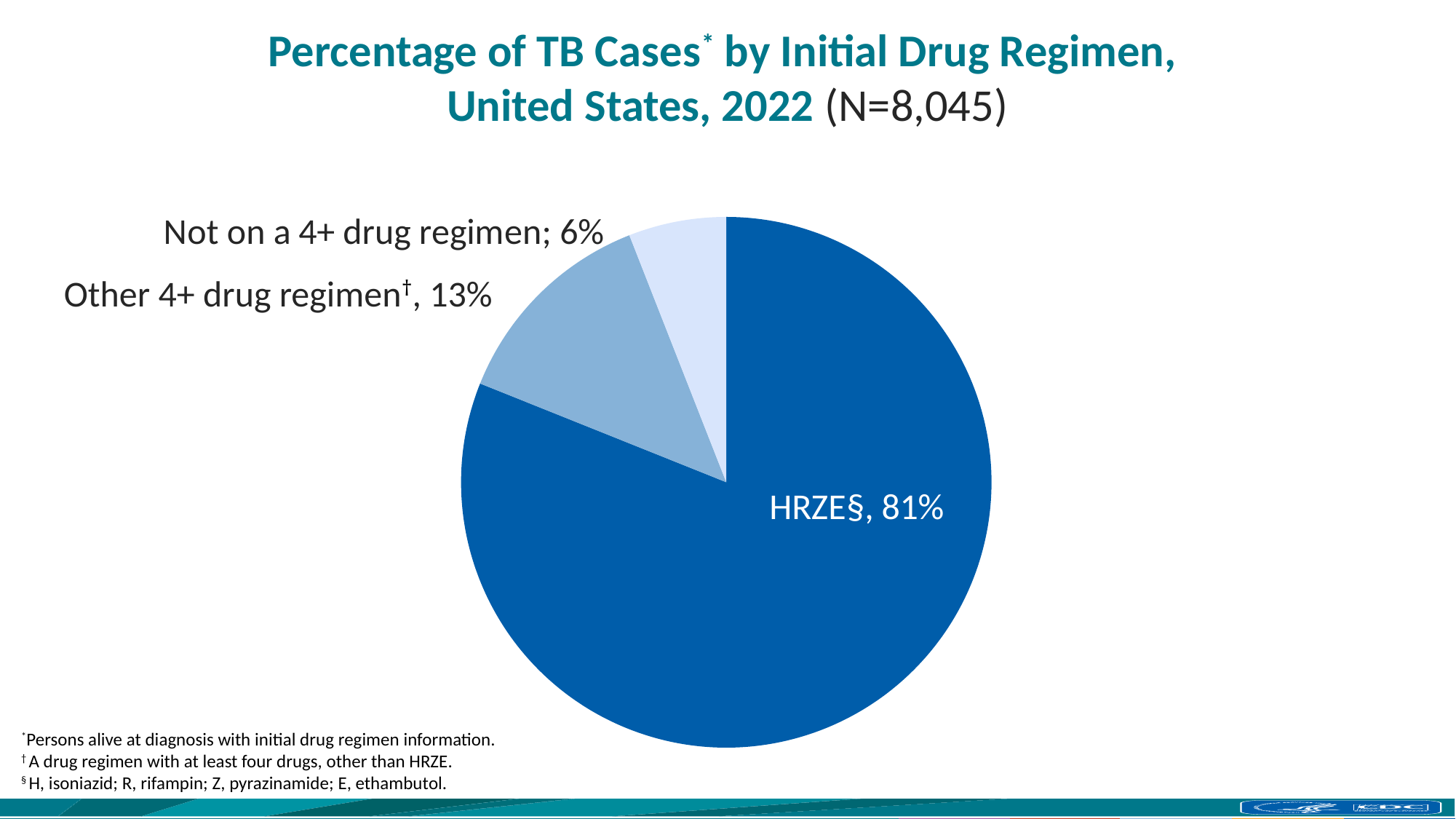
What kind of chart is shown on the slide? pie chart Which regimen category has the largest share of TB cases? HRZE What is the difference in percentage points between other 4+ drug regimen and not on a 4+ drug regimen? 7 Which is larger: the share for other 4+ drug regimen or the share for not on a 4+ drug regimen? Other 4+ drug regimen What year does the chart cover? 2022 What percentage of TB cases were on an other 4+ drug regimen? 13% What percentage of TB cases were on the HRZE regimen? 81% What percentage of TB cases were not on a 4+ drug regimen? 6% Which regimen category has the smallest share of TB cases? Not on a 4+ drug regimen What is the difference in percentage points between HRZE and other 4+ drug regimen? 68 How many slices does the pie chart have? 3 What is the total number of TB cases (N) given in the chart title? 8,045